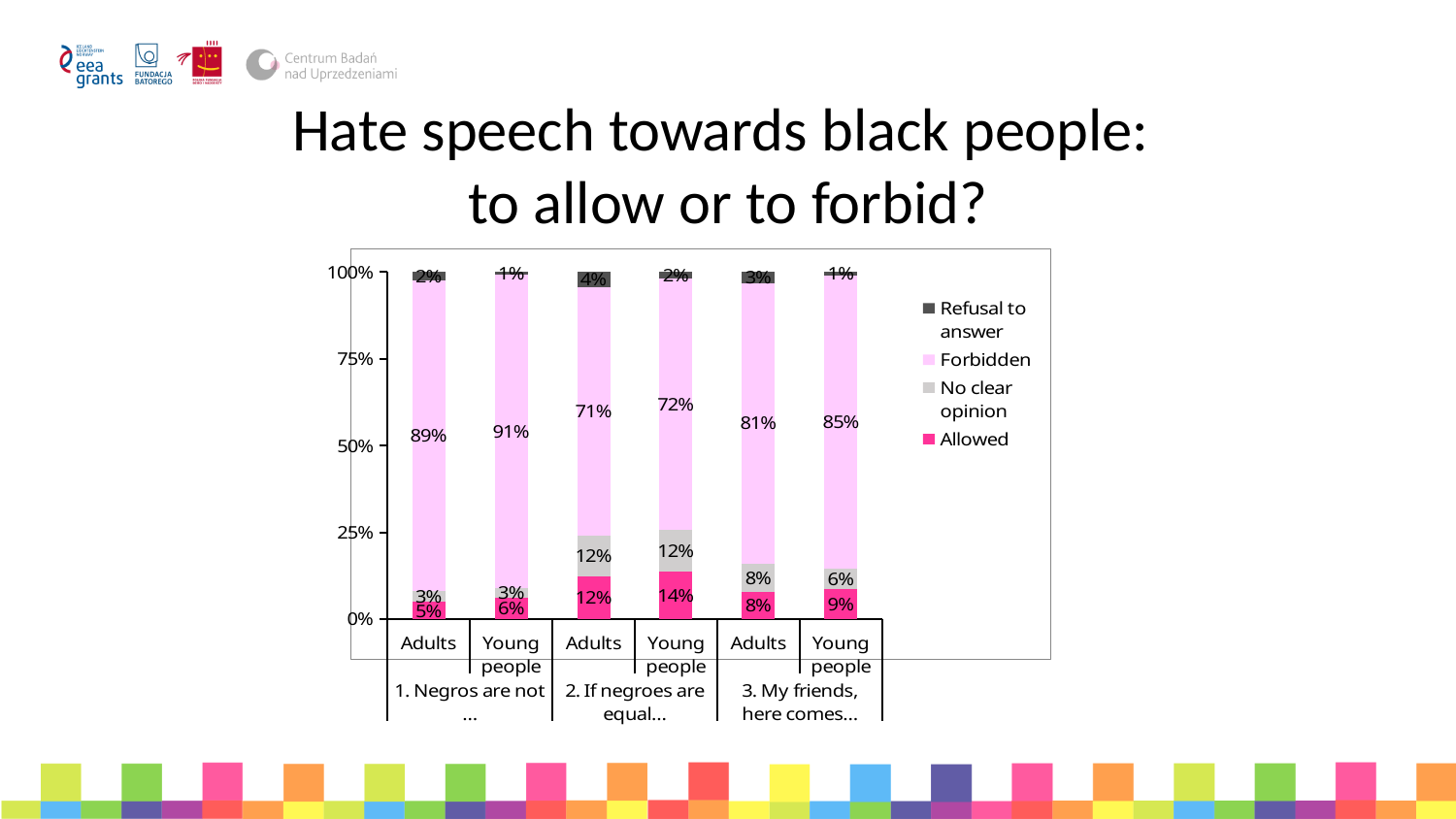
What is the No clear opinion value for Adults under statement 3 ("My friends, here comes...")? 8% Which legend entry is shown in dark grey/black? Refusal to answer How many series does the legend list? 4 What is the Refusal to answer value for Adults under statement 2 ("If negroes are equal...")? 4% What kind of chart is shown on the slide? Stacked bar chart What is the Allowed value for Young people under statement 2 ("If negroes are equal...")? 14% Which bar has the lowest Forbidden value? Adults, statement 2 (If negroes are equal...) What is the difference between the Forbidden values for Young people and Adults under statement 3 ("My friends, here comes...")? 4% What is the Forbidden value for Adults under statement 1 ("Negros are not ...")? 89% Which bar has the highest Forbidden value? Young people, statement 1 (Negros are not ...) How many bars are plotted in the chart? 6 Which is larger: the Allowed value for Adults or for Young people under statement 1 ("Negros are not ...")? Young people